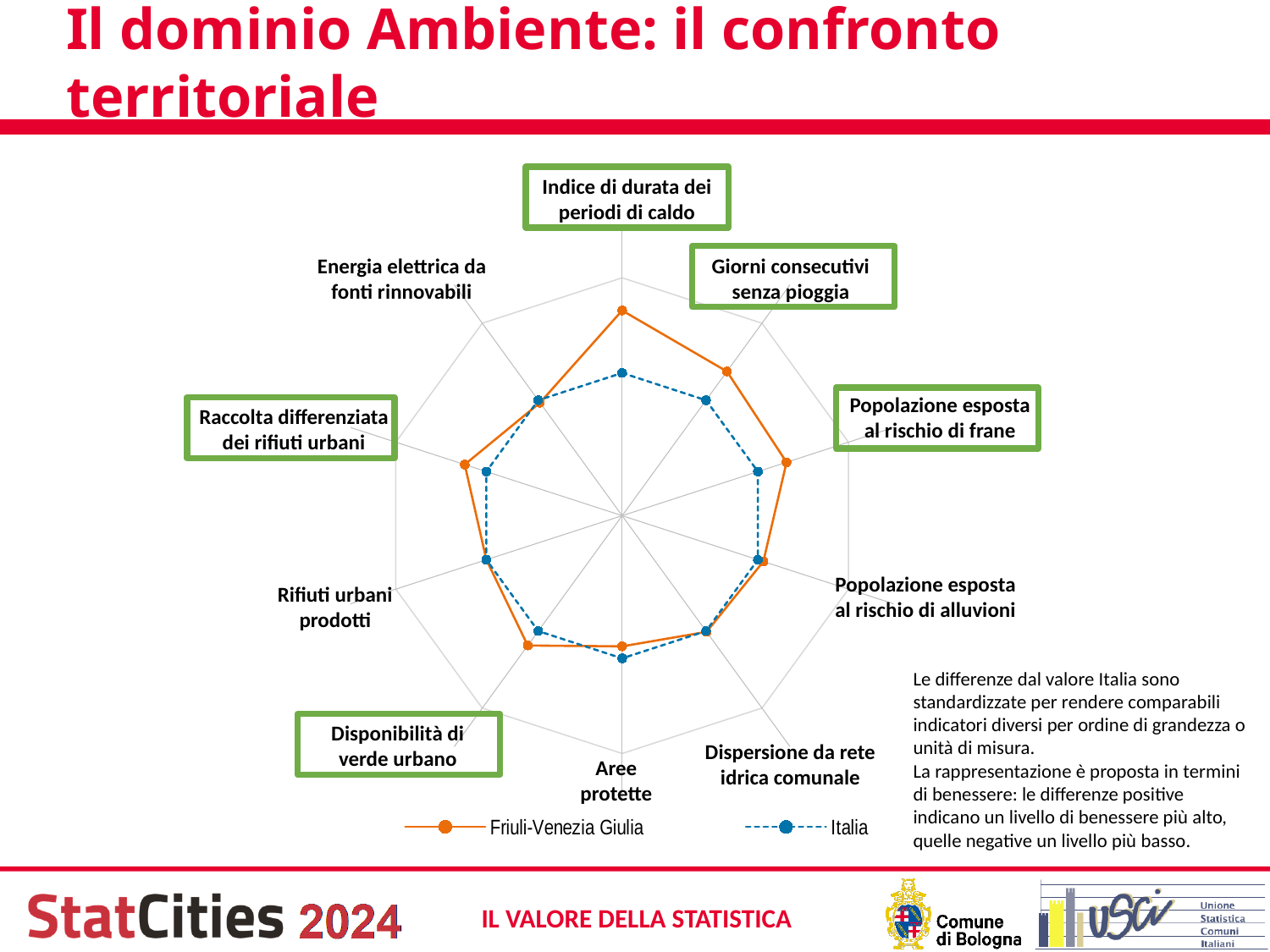
Which series is drawn with a dashed blue line in the chart? Italia For 'Giorni consecutivi senza pioggia', which series has the higher value, Friuli-Venezia Giulia or Italia? Friuli-Venezia Giulia How many indicator axes (categories) does the radar chart have? 10 What kind of chart is shown on the slide? Radar chart How many series does the legend of the chart list? 2 For 'Popolazione esposta al rischio di frane', is the Friuli-Venezia Giulia value higher or lower than the Italia value? Higher For 'Disponibilità di verde urbano', which series has the higher value, Friuli-Venezia Giulia or Italia? Friuli-Venezia Giulia On which indicator is the gap between Friuli-Venezia Giulia and Italia the largest? Indice di durata dei periodi di caldo Which two series are listed in the chart legend? Friuli-Venezia Giulia and Italia